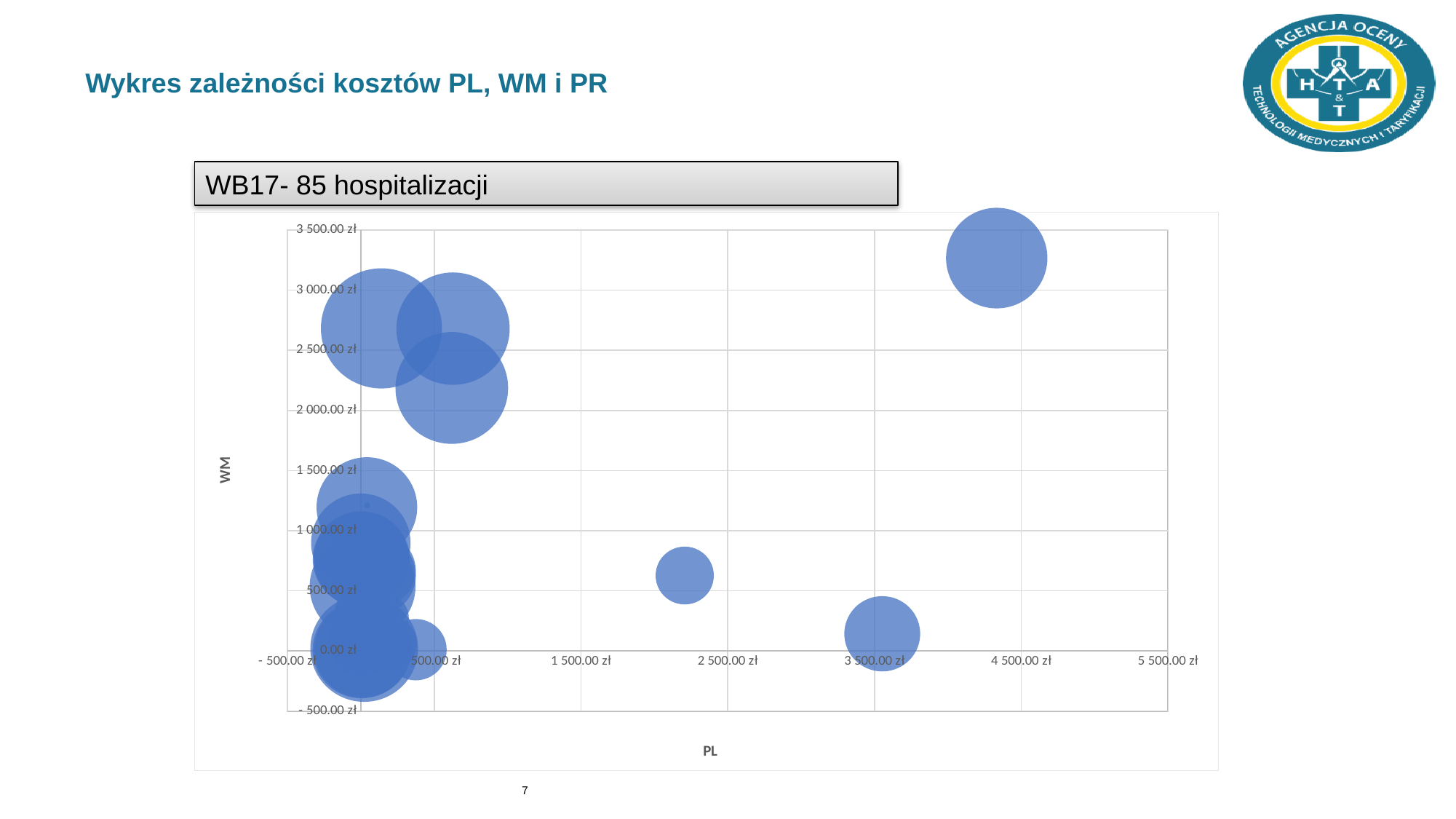
Is the PL value of the bubble with the highest WM value greater or less than 2 500.00 zł? greater What kind of chart is shown on the slide? Bubble chart Is the WM value of the bubble with the highest PL value greater or less than 3 000.00 zł? greater Is the WM value of the bubble located between 1 500.00 zł and 2 500.00 zł on the PL axis greater or less than 1 000.00 zł? less Which bubble has a higher WM value: the one near 3 500.00 zł on the PL axis or the one near 4 500.00 zł on the PL axis? The one near 4 500.00 zł What are the labels of the horizontal and vertical axes of the chart? PL (horizontal) and WM (vertical) What is the title shown above the chart? WB17- 85 hospitalizacji